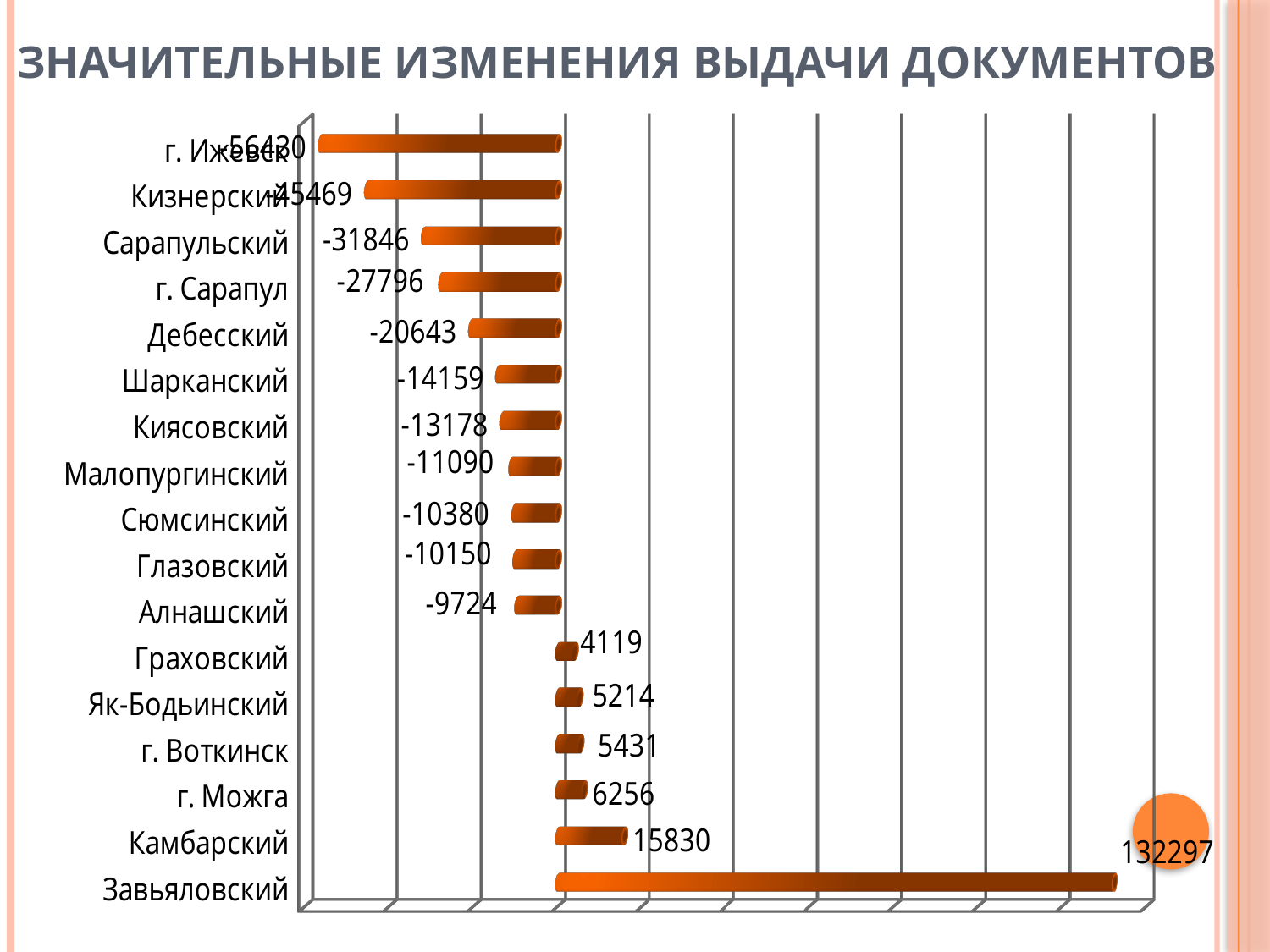
What is the title of the chart? ЗНАЧИТЕЛЬНЫЕ ИЗМЕНЕНИЯ ВЫДАЧИ ДОКУМЕНТОВ What is the value for Завьяловский? 132297 What is the value for Алнашский? -9724 Which category has the lowest value? г. Ижевск What is the value for Камбарский? 15830 What is the value for Сарапульский? -31846 What is the value for г. Воткинск? 5431 Which has the larger value, Камбарский or г. Можга? Камбарский How many categories are shown in the chart? 17 What type of chart is shown on the slide? bar chart What is the difference between the values for Камбарский and г. Можга? 9574 Which category has the highest value? Завьяловский